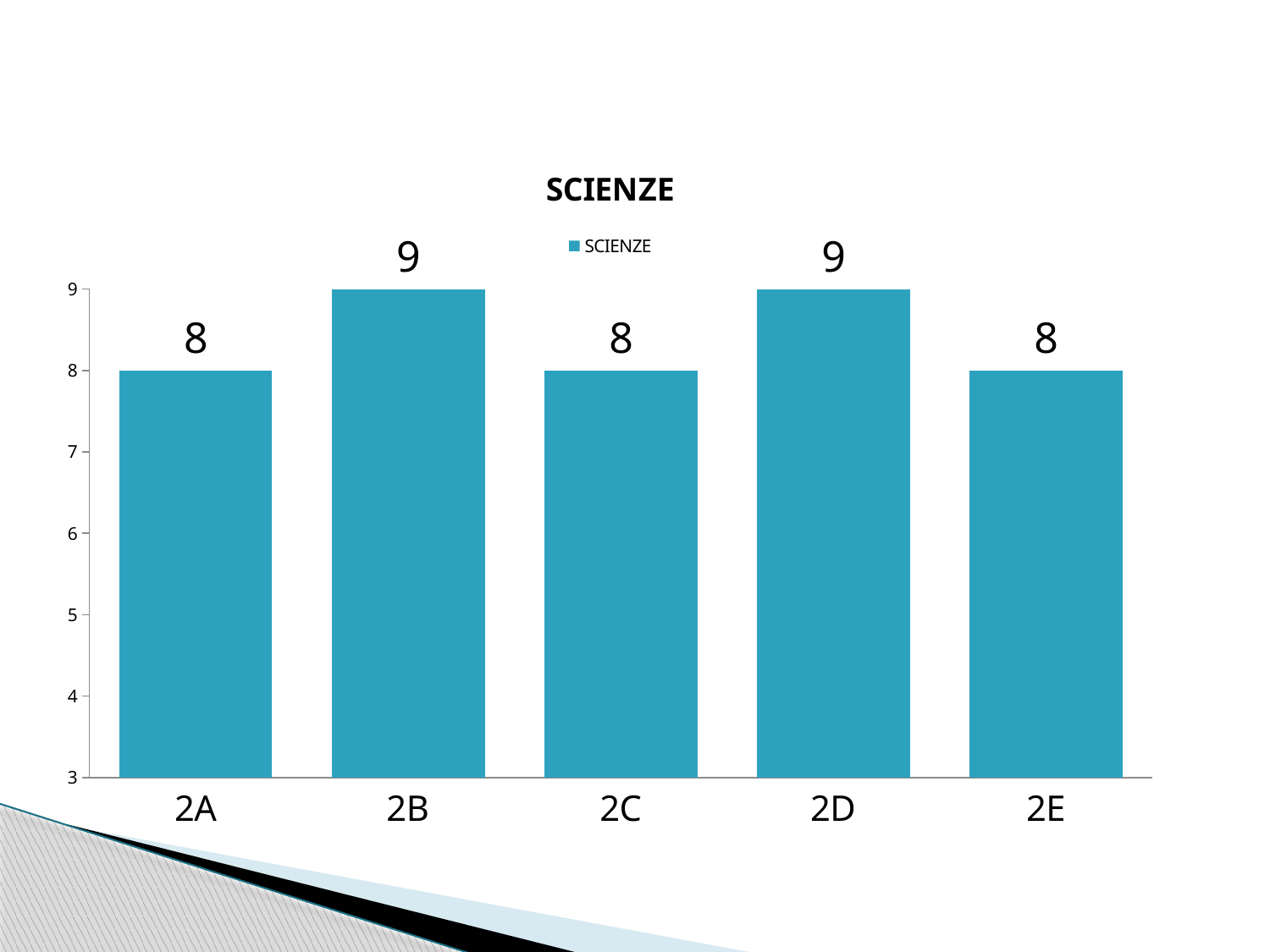
What is the lowest value shown on the y axis? 3 What is the value for 2A? 8 What is the title of the chart? SCIENZE What is the difference between the values for 2B and 2C? 1 What is the value for 2E? 8 How many series does the legend list? 1 How many categories are shown on the x axis? 5 Is the value for 2C greater or less than 7? greater What is the value for 2D? 9 What kind of chart is shown? bar chart Which is larger, the value for 2D or the value for 2E? 2D What is the value for 2B? 9